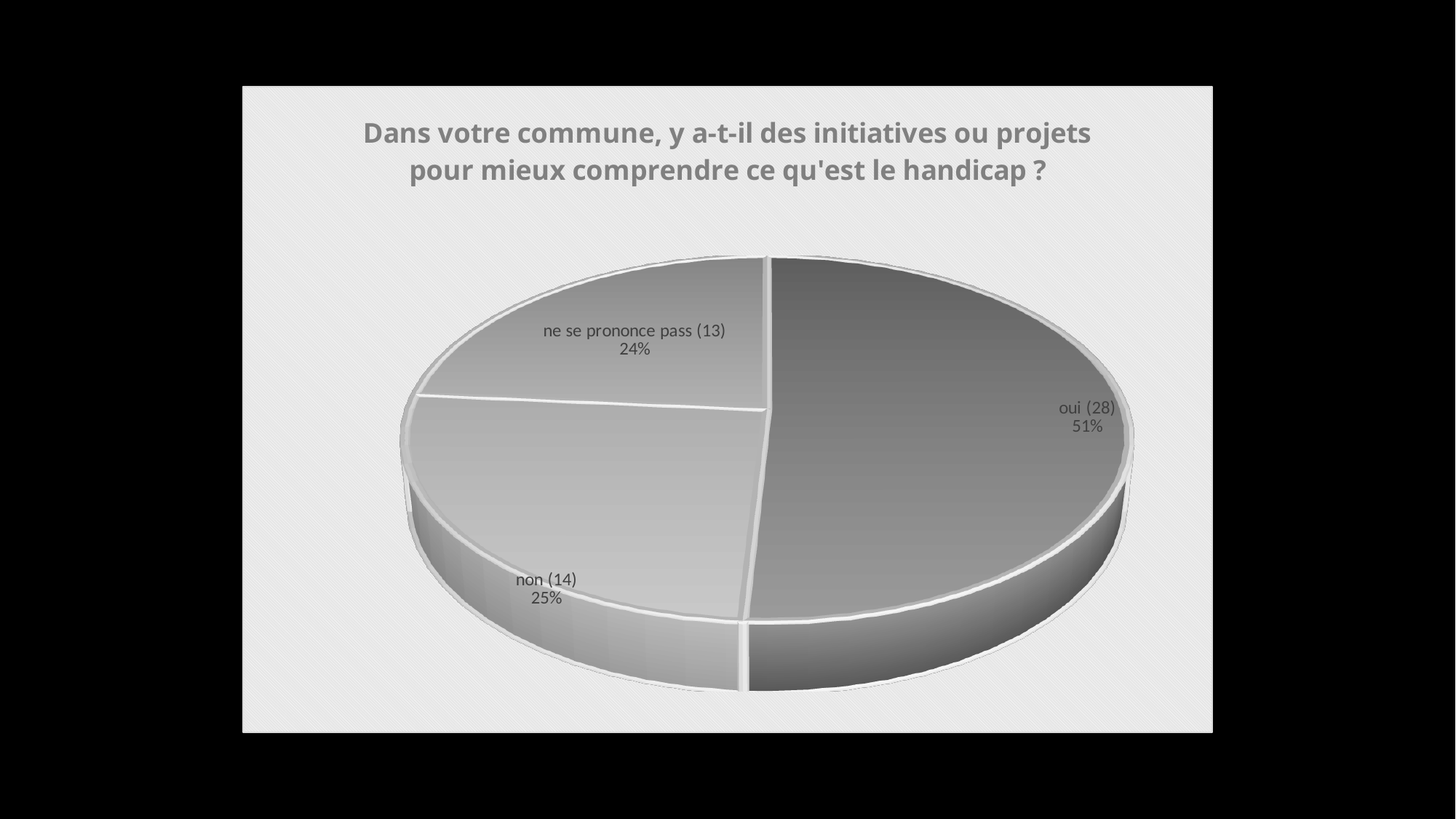
What is the difference in respondent count between 'oui' and 'non'? 14 What percentage share does the 'ne se prononce pass' slice have? 24% What percentage share does the 'oui' slice have? 51% What kind of chart is shown on the slide? pie chart How many slices does the pie chart have? 3 Which category has the largest slice? oui What is the title of the chart? Dans votre commune, y a-t-il des initiatives ou projets pour mieux comprendre ce qu'est le handicap ? Which category has the smallest slice? ne se prononce pass How many respondents answered 'oui'? 28 What percentage share does the 'non' slice have? 25% How many respondents answered 'non'? 14 How many respondents are in the 'ne se prononce pass' category? 13